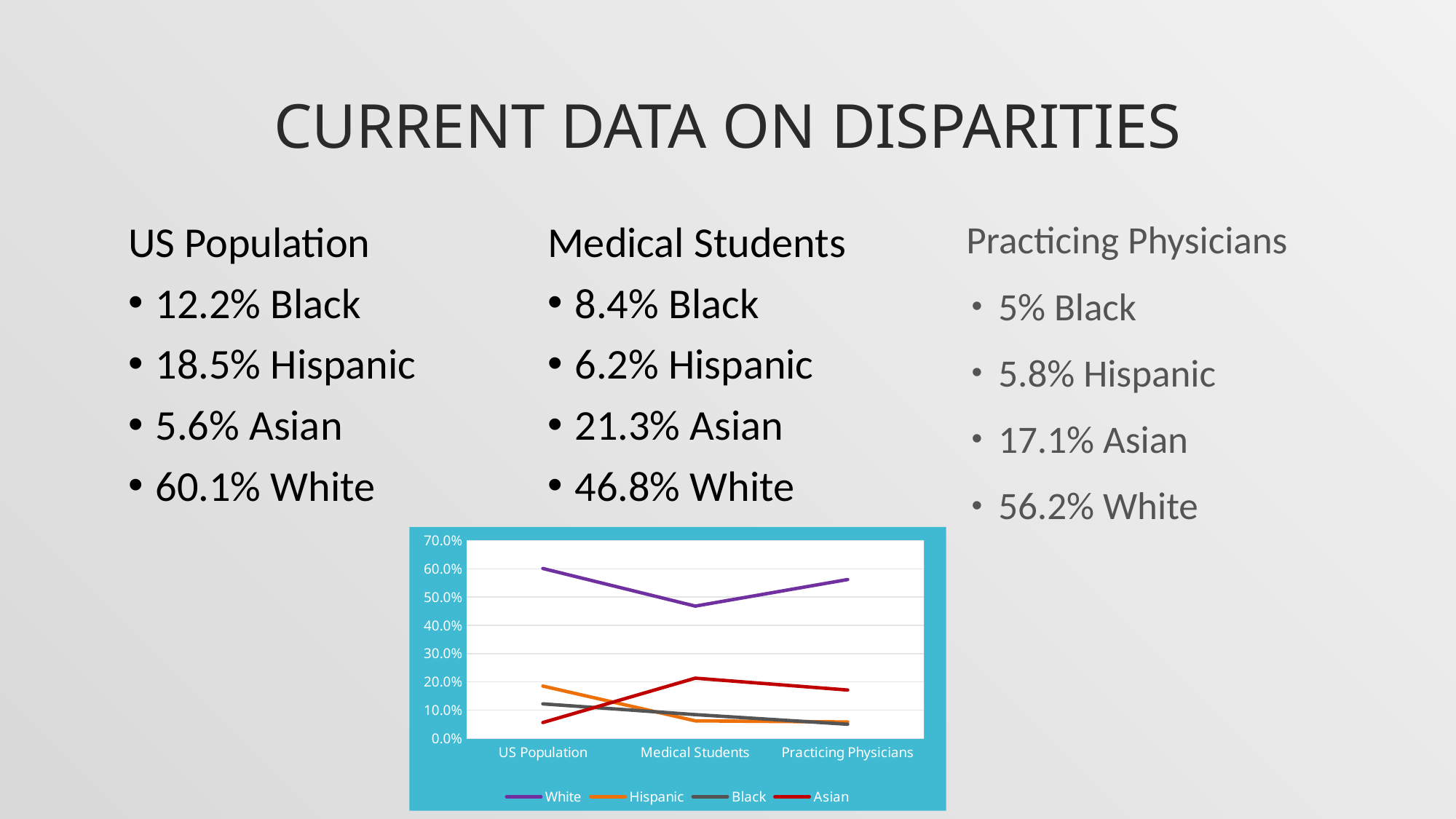
Which series has the highest value at Medical Students in the chart? White At Practicing Physicians, which is larger in the chart: the Asian value or the Black value? Asian How many series does the chart's legend list? 4 According to the slide, what is the White value for Medical Students plotted in the chart? 46.8% Is the value for White at US Population greater or less than 50.0%? greater How many categories are on the x axis of the chart? 3 Which series is plotted with the purple line in the chart? White Is the value for Asian at Medical Students greater or less than 20.0%? greater What kind of chart is shown on the slide? line chart Does the Hispanic line rise or fall from US Population to Medical Students? fall Which series has the lowest value at US Population in the chart? Asian Is the value for White at Medical Students greater or less than 50.0%? less